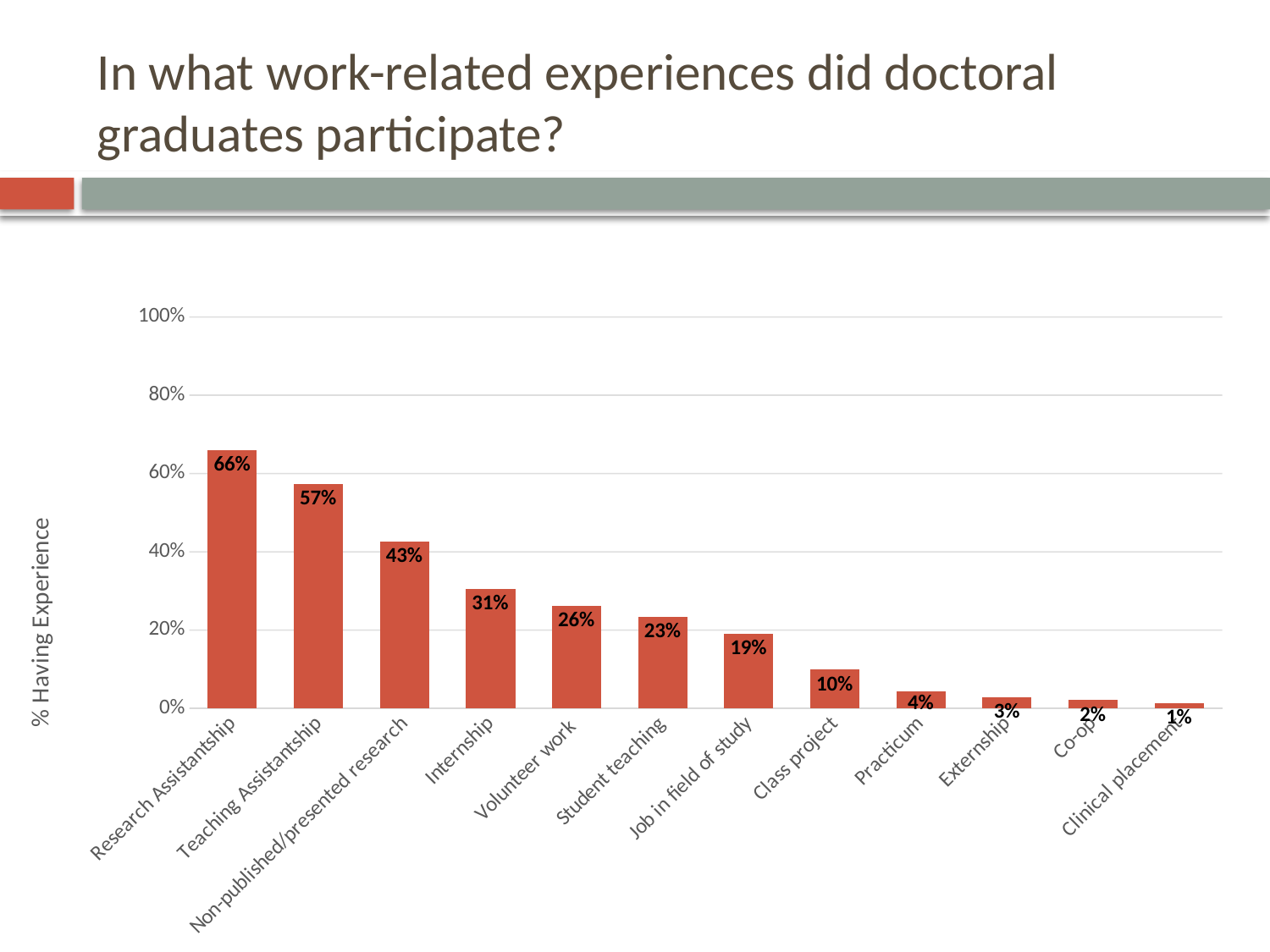
What percentage of doctoral graduates participated in Student teaching? 23% What is the value for Internship? 31% Which work-related experience has the highest percentage? Research Assistantship How many work-related experience categories are shown in the chart? 12 Which is larger, Non-published/presented research or Internship? Non-published/presented research What kind of chart is shown on the slide? bar chart What percentage of doctoral graduates had a Research Assistantship? 66% Which work-related experience has the lowest percentage? Clinical placement What is the difference between the Teaching Assistantship and Research Assistantship percentages? 9% What is the label on the vertical axis of the chart? % Having Experience Is the value for Class project greater or less than 20%? less What is the difference between Volunteer work and Job in field of study? 7%